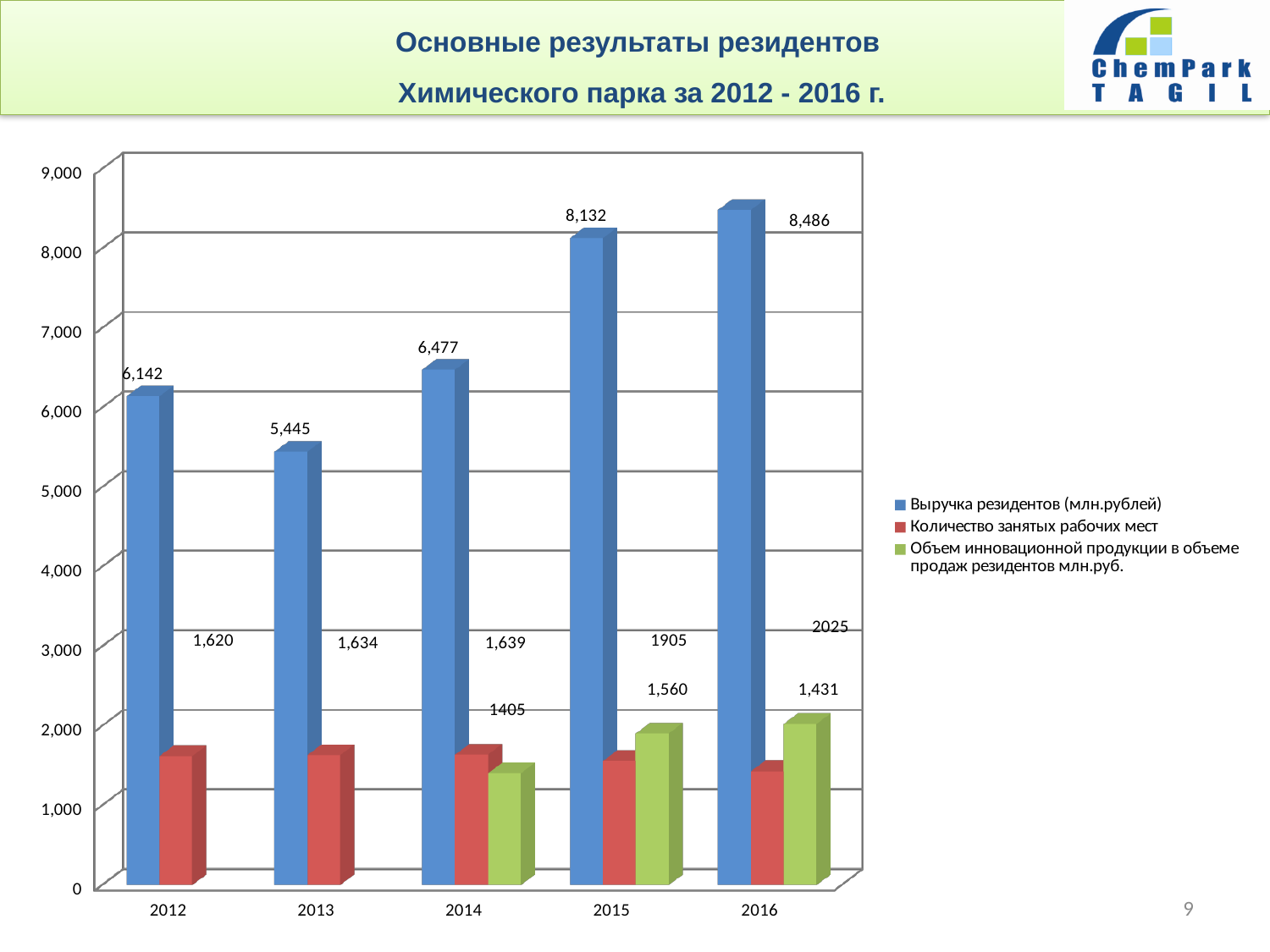
What was the volume of innovative products (Объем инновационной продукции) in 2015? 1905 How many years are shown on the x axis? 5 In which year was the revenue of residents the highest? 2016 What was the revenue of residents (Выручка резидентов) in 2013? 5,445 By how much did the revenue of residents increase from 2015 to 2016? 354 What type of chart is shown on the slide? Bar chart Does the volume of innovative products rise or fall from 2014 to 2016? Rise What was the number of jobs (Количество занятых рабочих мест) in 2012? 1,620 What was the revenue of residents (Выручка резидентов) in 2016? 8,486 How many series does the legend list? 3 In which year was the revenue of residents the lowest? 2013 Which is larger in 2016: the number of jobs or the volume of innovative products? Volume of innovative products (2025)